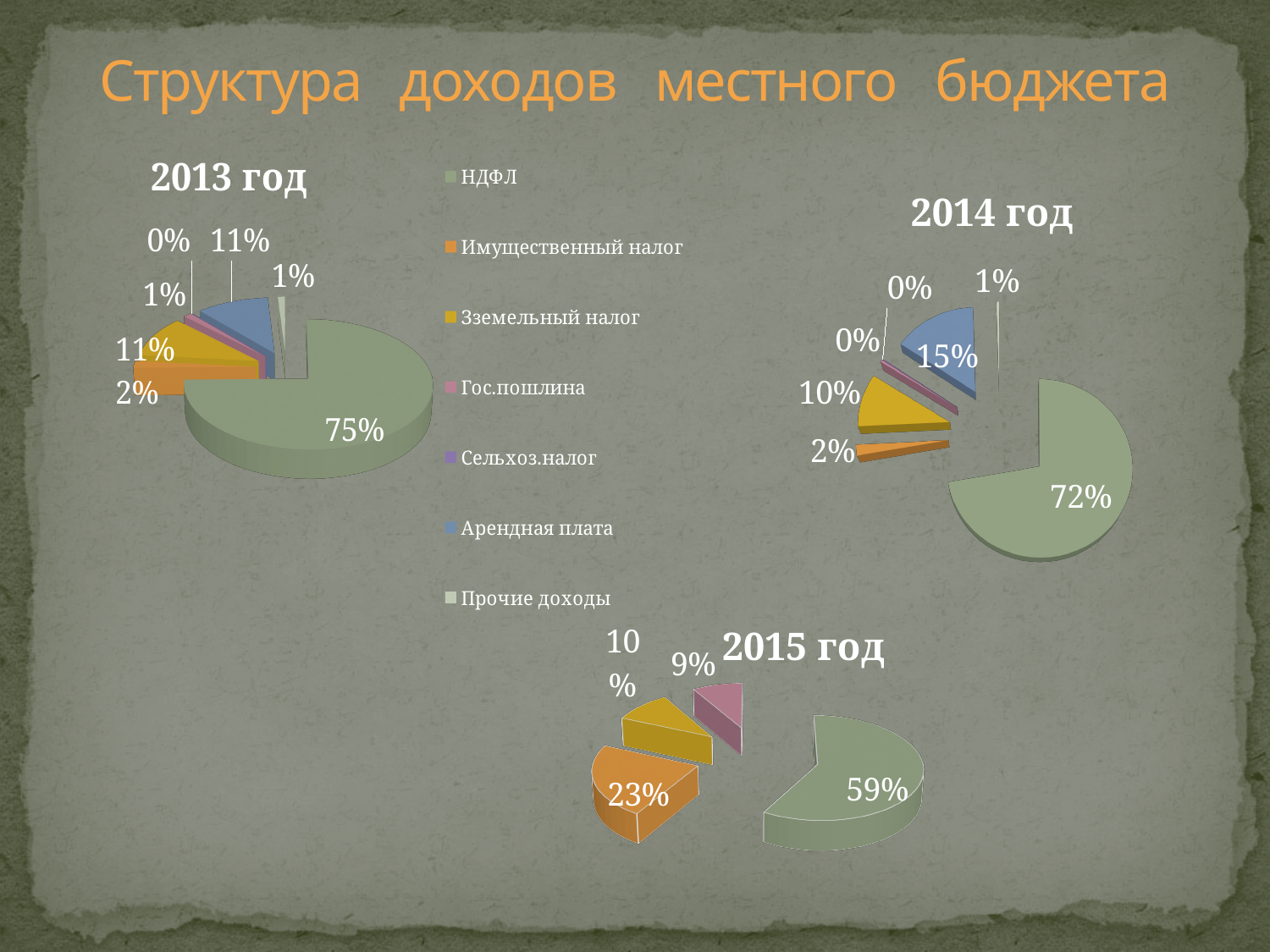
What is the title of the slide? Структура доходов местного бюджета In the 2014 год chart, what share does НДФЛ have? 72% In the 2014 год chart, which category has the largest share? НДФЛ In the 2015 год chart, what share does НДФЛ have? 59% By how many percentage points is the НДФЛ share in the 2013 год chart larger than in the 2015 год chart? 16 In the 2013 год chart, what share does НДФЛ have? 75% In the 2015 год chart, what share does Имущественный налог have? 23% What kind of charts are shown on the slide? Pie charts In the 2015 год chart, which is larger: the share of Земельный налог or the share of Гос.пошлина? Земельный налог In the 2014 год chart, what share does Арендная плата have? 15% How many pie charts are on the slide? 3 How many categories does the legend list? 7